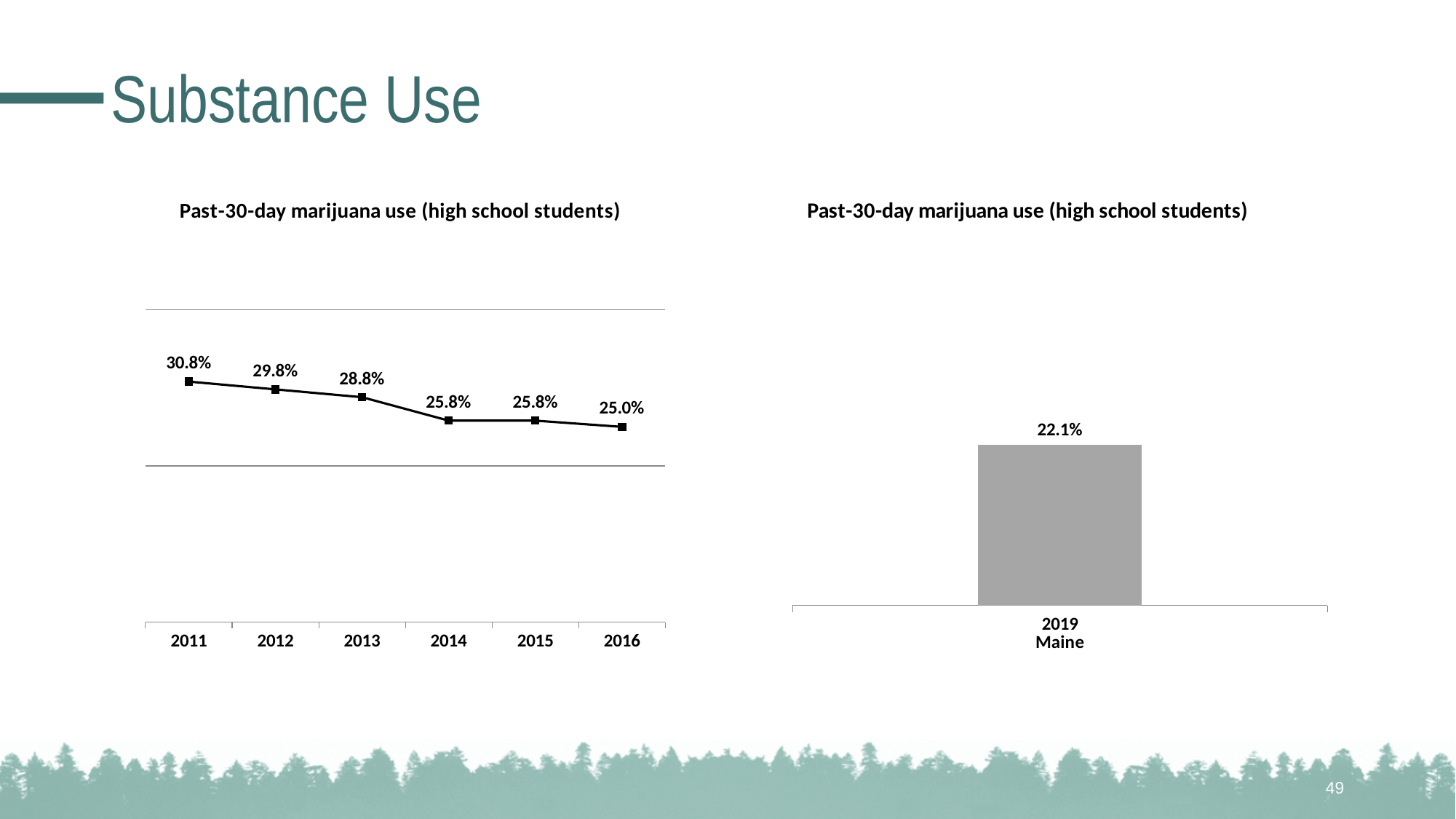
In the left chart, what was past-30-day marijuana use among high school students in 2011? 30.8% In the right chart, what is the past-30-day marijuana use value for Maine in 2019? 22.1% How many years are plotted in the left chart? 6 What kind of chart is the right chart? bar chart What kind of chart is the left chart? line chart In the left chart, is the value for 2012 larger or smaller than the value for 2014? larger In the left chart, do the values rise or fall from 2011 to 2016? fall In the left chart, what is the difference between the 2011 and 2016 values? 5.8% In the left chart, which year has the lowest past-30-day marijuana use? 2016 In the left chart, what value is shown for 2013? 28.8% In the left chart, what was past-30-day marijuana use among high school students in 2016? 25.0% In the left chart, which year has the highest past-30-day marijuana use? 2011